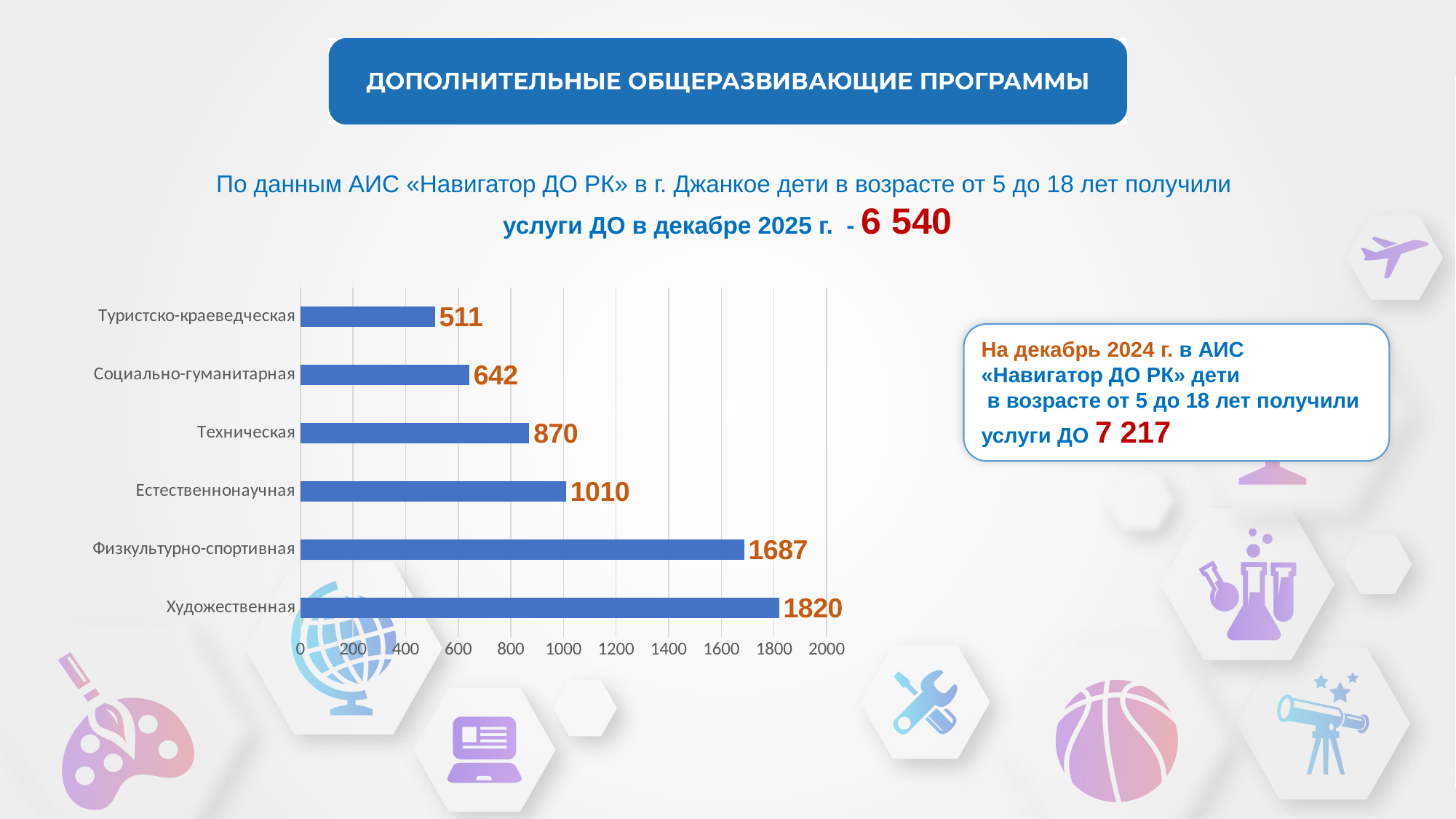
What is the value for Художественная? 1820 How many categories are shown in the chart? 6 What is the maximum value shown on the horizontal axis of the chart? 2000 Is the value for Естественнонаучная greater or less than 1000? greater What is the value for Техническая? 870 Which category has the lowest value? Туристско-краеведческая Which is larger, the value for Техническая or the value for Социально-гуманитарная? Техническая What is the difference between the values for Естественнонаучная and Туристско-краеведческая? 499 What is the difference between the values for Художественная and Физкультурно-спортивная? 133 What is the value for Социально-гуманитарная? 642 What kind of chart is shown on the slide? bar chart Which category has the highest value? Художественная